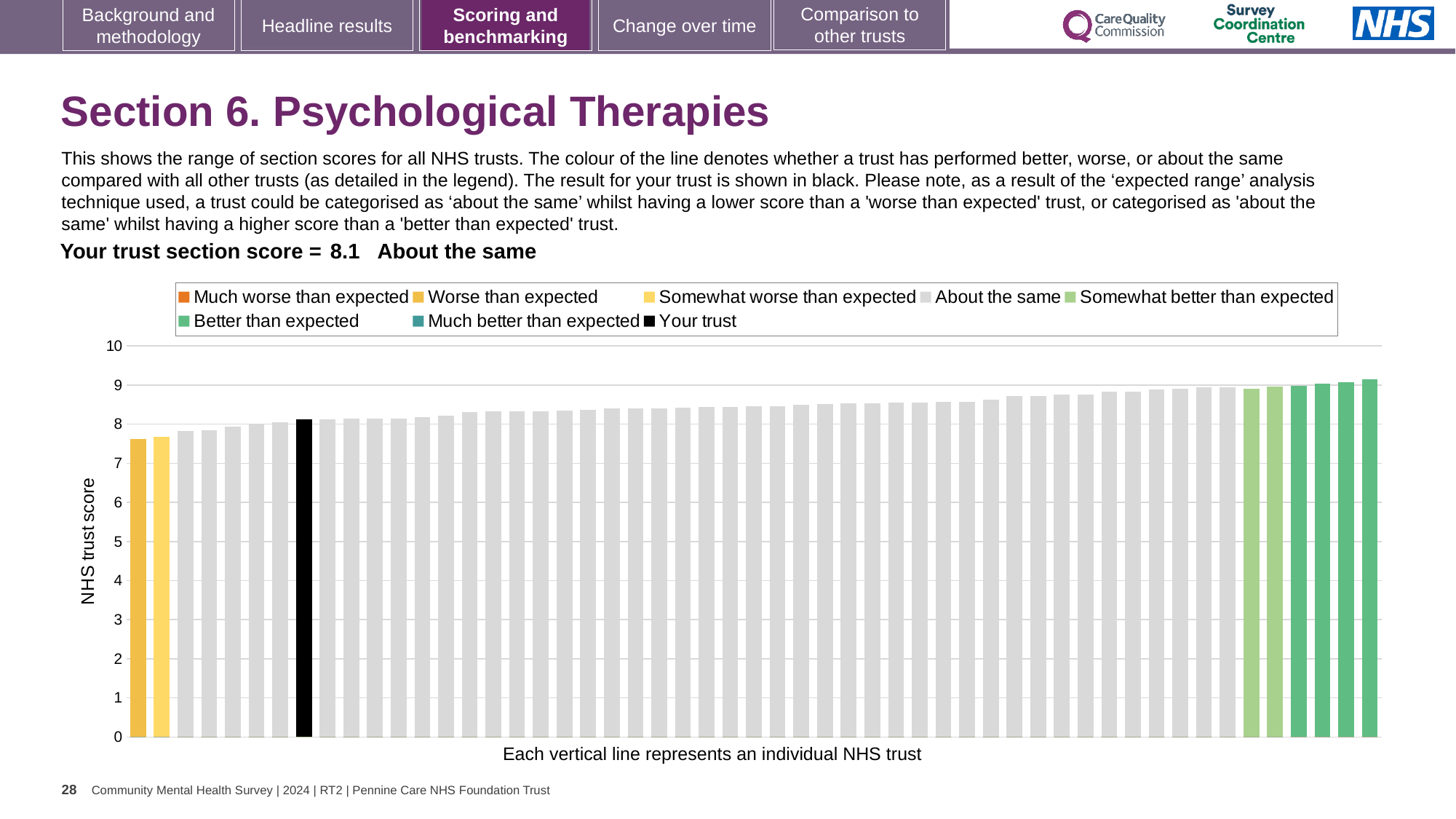
Is the value of the rightmost bar greater or less than 8? greater Do the bar values rise or fall from left to right along the x axis? rise Which is larger: the score of your trust or the score of the leftmost bar? your trust How many entries does the chart legend list? 8 Is the value of the leftmost bar greater or less than 8? less What is the label on the y axis of the chart? NHS trust score Is the value of the black 'Your trust' bar greater or less than 5? greater What category does your trust fall into according to the slide? About the same What colour is used to show your trust's bar? black What is the section score for your trust shown on the slide? 8.1 What kind of chart is used to show the range of section scores? bar chart Which bar has the highest score: the leftmost bar or the rightmost bar? the rightmost bar